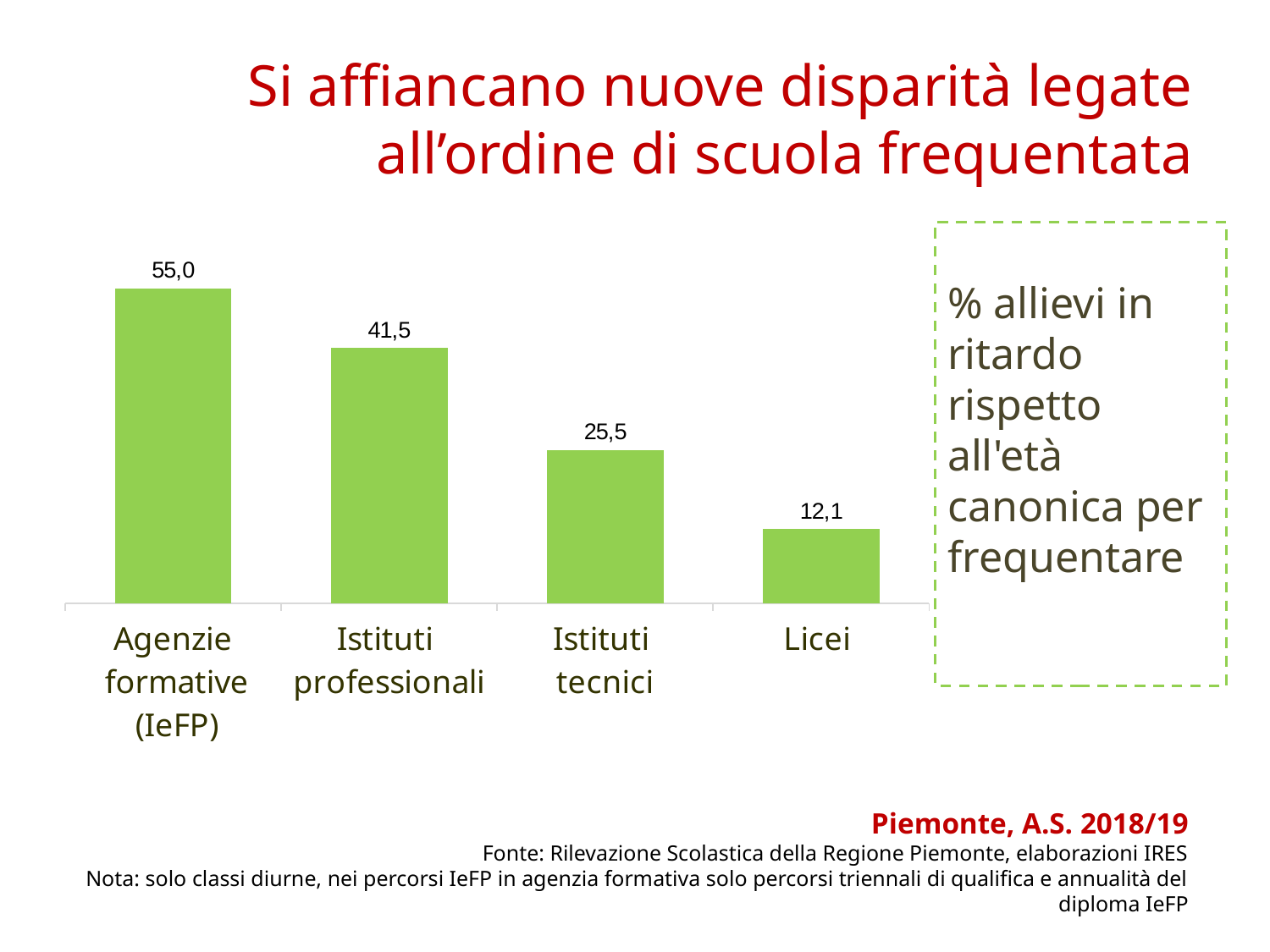
Which category has the lowest value? Licei Do the values rise or fall from left to right across the categories? Fall What is the value for Agenzie formative (IeFP)? 55,0 How many categories are shown in the chart? 4 What is the value for Licei? 12,1 Which category has the highest value? Agenzie formative (IeFP) Which is larger, the value for Istituti tecnici or the value for Licei? Istituti tecnici What is the value for Istituti professionali? 41,5 What is the difference between the values for Istituti professionali and Istituti tecnici? 16,0 What is the difference between the values for Agenzie formative (IeFP) and Licei? 42,9 What is the value for Istituti tecnici? 25,5 What kind of chart is shown on the slide? Bar chart